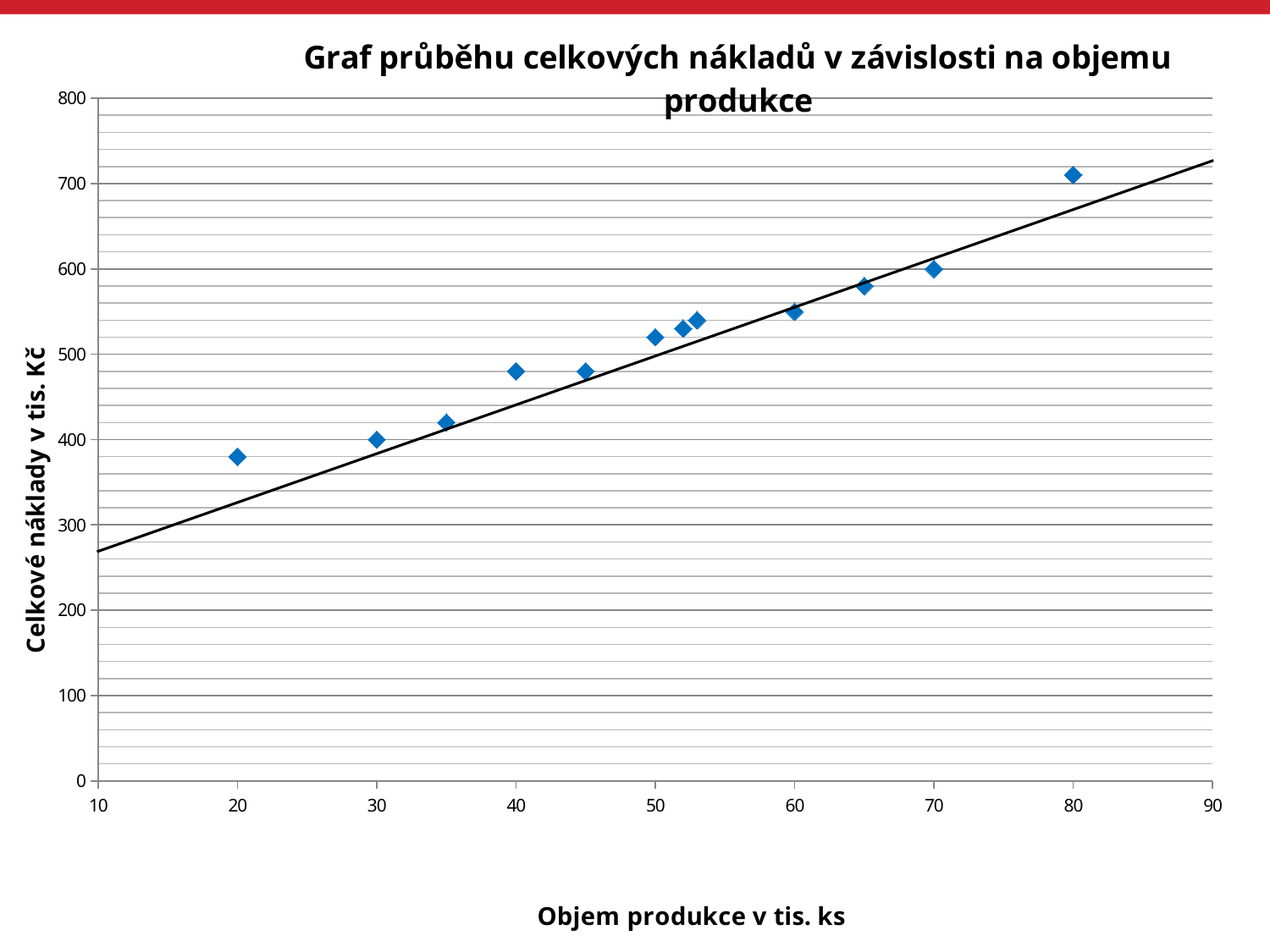
What is the title of the chart? Graf průběhu celkových nákladů v závislosti na objemu produkce At which production volume (x value) is the plotted total cost lowest? 20 Is the total cost at a production volume of 30 greater or less than 500? less Do the total costs rise or fall as production volume increases along the x axis? rise Which has the higher total cost: the point at production volume 70 or the point at production volume 40? 70 What kind of chart is shown on the slide? scatter chart Is the total cost at a production volume of 60 greater or less than 500? greater What is the label of the vertical axis? Celkové náklady v tis. Kč At which production volume (x value) is the plotted total cost highest? 80 How many data points are plotted on the chart? 12 Is the total cost at a production volume of 20 greater or less than 400? less